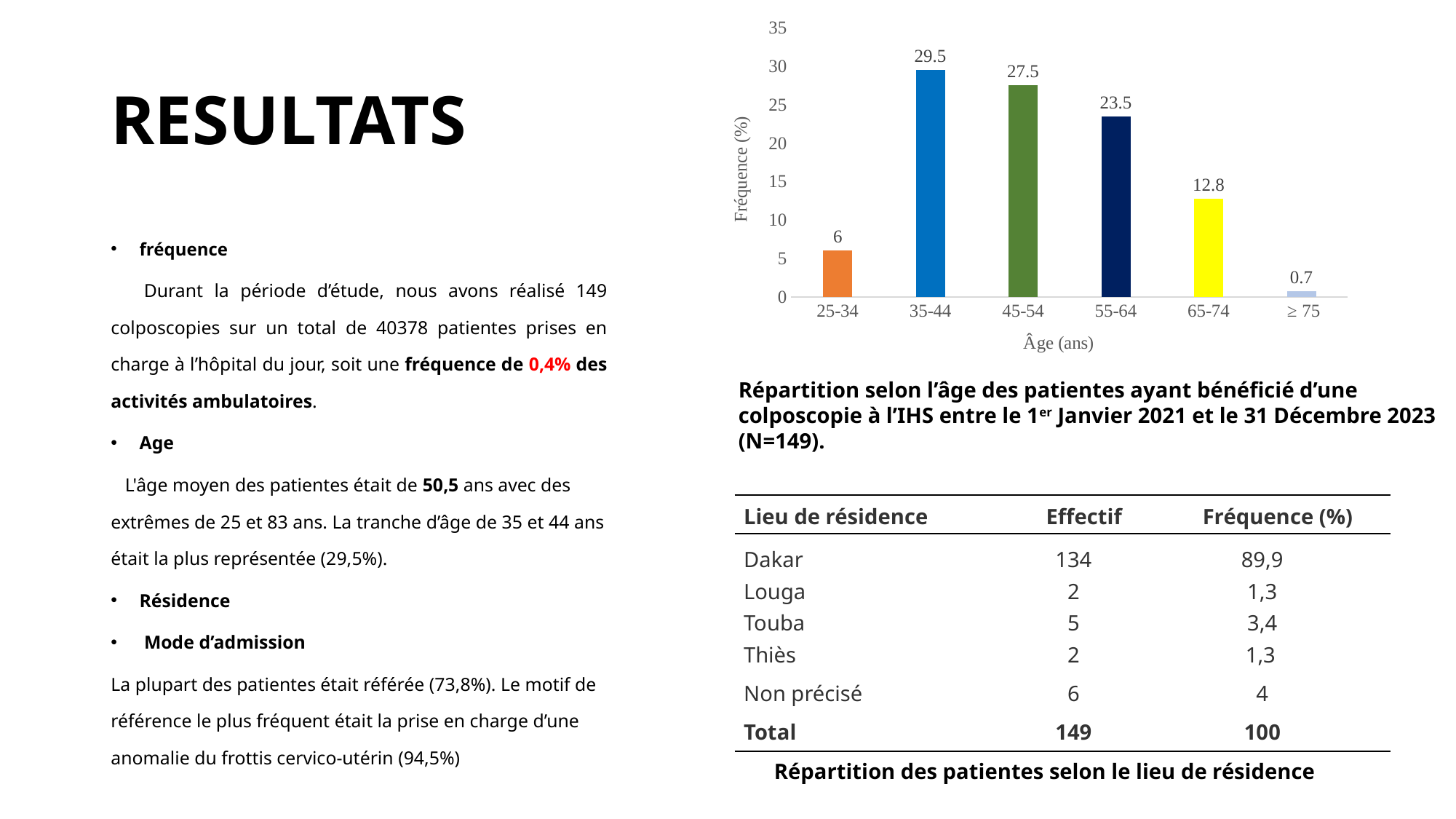
What is the difference between the values for 45-54 and 55-64? 4 Which age group has the lowest frequency? ≥ 75 What is the value for the 65-74 age group? 12.8 What is the label of the y axis? Fréquence (%) What is the value for the ≥ 75 age group? 0.7 What is the value for the 35-44 age group? 29.5 Is the value for 55-64 greater or less than 20? greater What kind of chart is shown? bar chart Do the values rise or fall from the 35-44 group to the ≥ 75 group? fall How many age groups are shown on the x axis? 6 Which is larger, the value for 25-34 or the value for 65-74? 65-74 Which age group has the highest frequency? 35-44